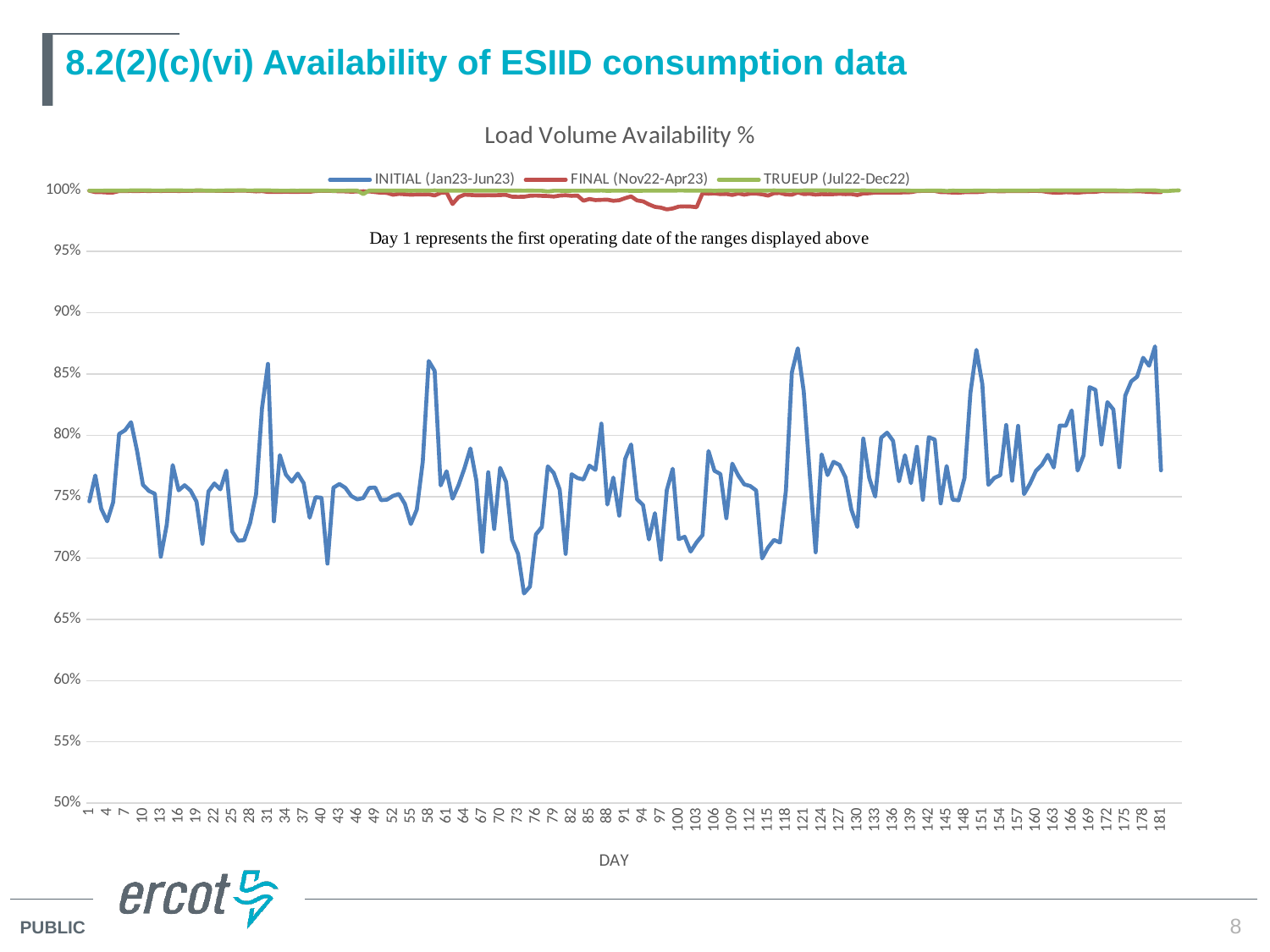
Is the value for TRUEUP (Jul22-Dec22) on day 181 greater or less than 95%? greater Which is larger on day 1: the value for INITIAL (Jan23-Jun23) or the value for TRUEUP (Jul22-Dec22)? TRUEUP (Jul22-Dec22) Does the INITIAL (Jan23-Jun23) series generally rise or fall from day 1 to day 181? rise Is the value for INITIAL (Jan23-Jun23) on day 1 greater or less than 80%? less Is the value for FINAL (Nov22-Apr23) on day 1 greater or less than 95%? greater What is the lowest value shown on the y axis? 50% What kind of chart is shown on the slide? line chart What is the label of the x axis? DAY What is the title of the chart? Load Volume Availability % How many series does the legend list? 3 Which series has the lowest values across the chart? INITIAL (Jan23-Jun23)